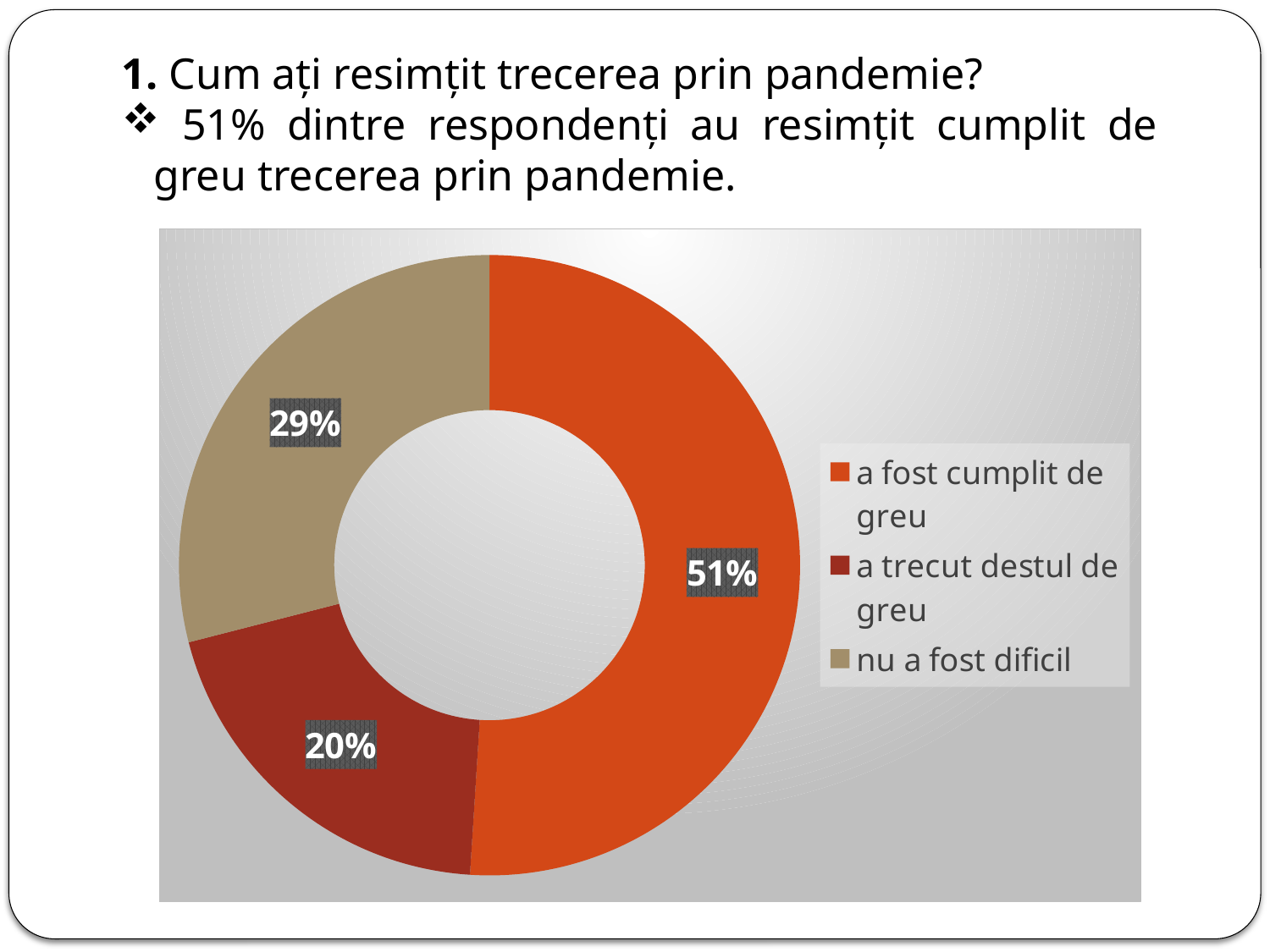
What share of respondents answered "nu a fost dificil"? 29% What kind of chart is shown on the slide? Doughnut (pie) chart Which is larger: the share for "nu a fost dificil" or the share for "a trecut destul de greu"? nu a fost dificil What share of respondents answered "a fost cumplit de greu"? 51% Which category is shown in orange in the chart? a fost cumplit de greu Which category has the largest share of the chart? a fost cumplit de greu What is the difference in percentage points between "nu a fost dificil" and "a trecut destul de greu"? 9 How many entries does the legend list? 3 Which category has the smallest share of the chart? a trecut destul de greu How many categories does the chart show? 3 What is the difference in percentage points between "a fost cumplit de greu" and "nu a fost dificil"? 22 What share of respondents answered "a trecut destul de greu"? 20%